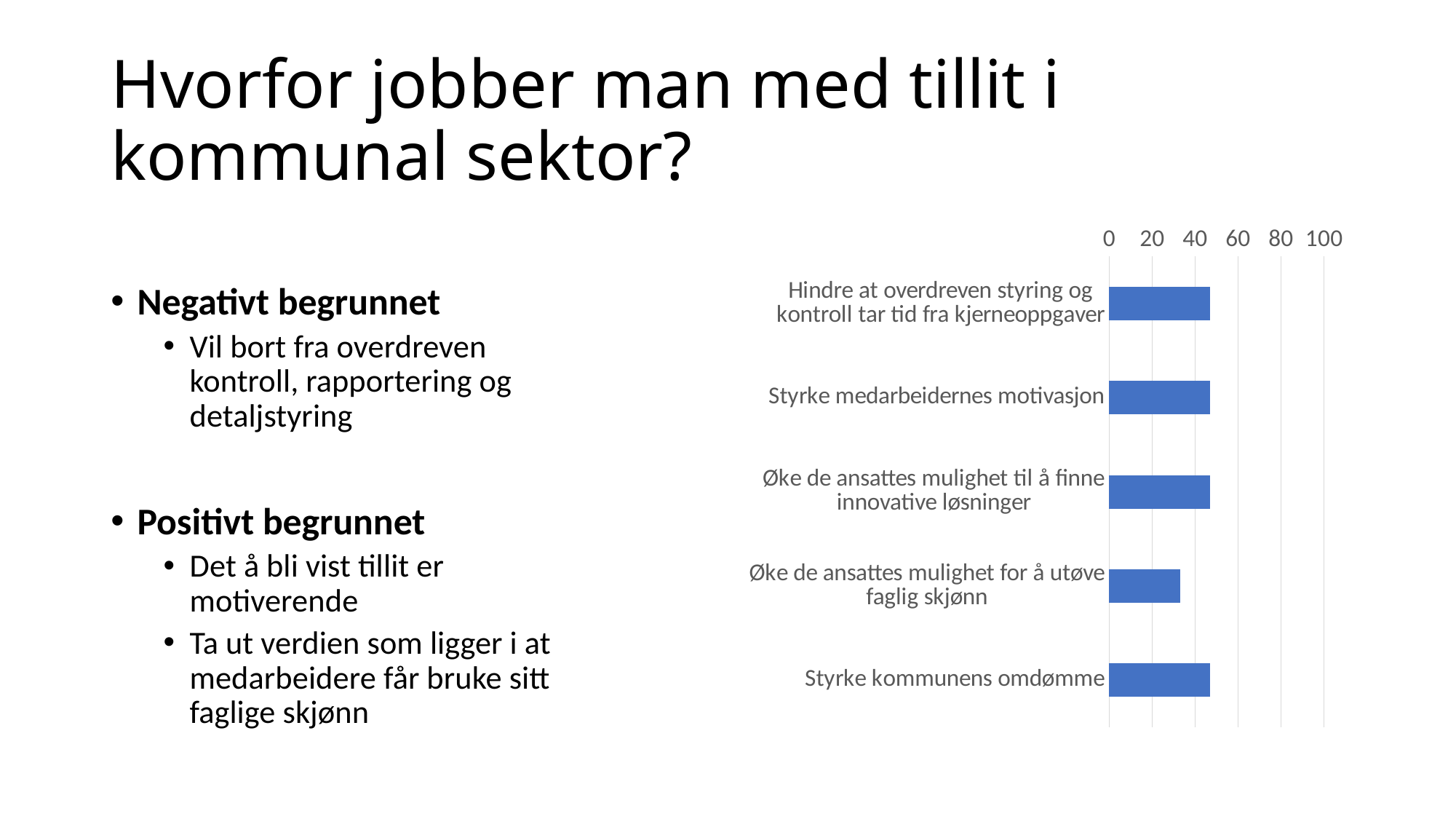
Is the value for "Øke de ansattes mulighet for å utøve faglig skjønn" greater or less than 40? less Which is larger: the value for "Øke de ansattes mulighet for å utøve faglig skjønn" or the value for "Styrke kommunens omdømme"? Styrke kommunens omdømme What colour are the bars in the chart? blue Is the value for "Styrke kommunens omdømme" greater or less than 40? greater What is the highest value shown on the chart's value axis? 100 Is the value for "Styrke medarbeidernes motivasjon" greater or less than 60? less Which category has the lowest value in the chart? Øke de ansattes mulighet for å utøve faglig skjønn Which is larger: the value for "Styrke medarbeidernes motivasjon" or the value for "Øke de ansattes mulighet for å utøve faglig skjønn"? Styrke medarbeidernes motivasjon What kind of chart is shown on the slide? bar chart How many categories are plotted in the chart? 5